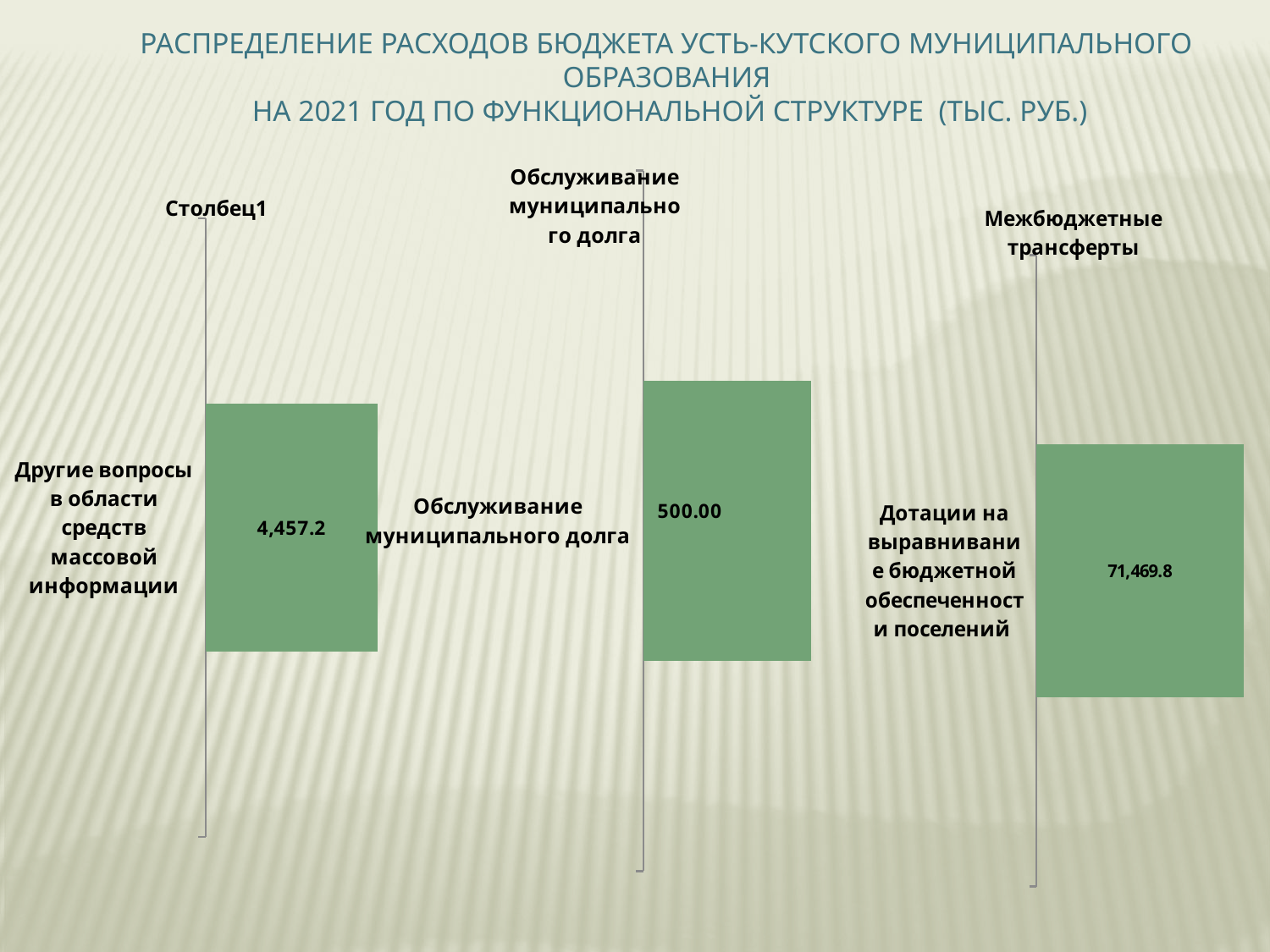
In the middle chart titled "Обслуживание муниципального долга", what value is shown on the bar? 500.00 What is the title of the chart on the left of the slide? Столбец1 How many bars are plotted in the middle chart titled "Обслуживание муниципального долга"? 1 Which is larger: the value in the left chart "Столбец1" (4,457.2) or the value in the middle chart "Обслуживание муниципального долга" (500.00)? Столбец1 (4,457.2) In the left chart titled "Столбец1", what is the value for "Другие вопросы в области средств массовой информации"? 4,457.2 What is the category label of the bar in the right chart titled "Межбюджетные трансферты"? Дотации на выравнивание бюджетной обеспеченности поселений What is the difference between the value in the right chart "Межбюджетные трансферты" (71,469.8) and the value in the left chart "Столбец1" (4,457.2)? 67,012.6 What is the difference between the value in the left chart "Столбец1" (4,457.2) and the value in the middle chart "Обслуживание муниципального долга" (500.00)? 3,957.2 In the right chart titled "Межбюджетные трансферты", what is the value for "Дотации на выравнивание бюджетной обеспеченности поселений"? 71,469.8 Which is larger: the value in the right chart "Межбюджетные трансферты" or the value in the left chart "Столбец1"? Межбюджетные трансферты (71,469.8) What kind of chart is the left chart titled "Столбец1"? Bar chart How many bars are plotted in the right chart titled "Межбюджетные трансферты"? 1